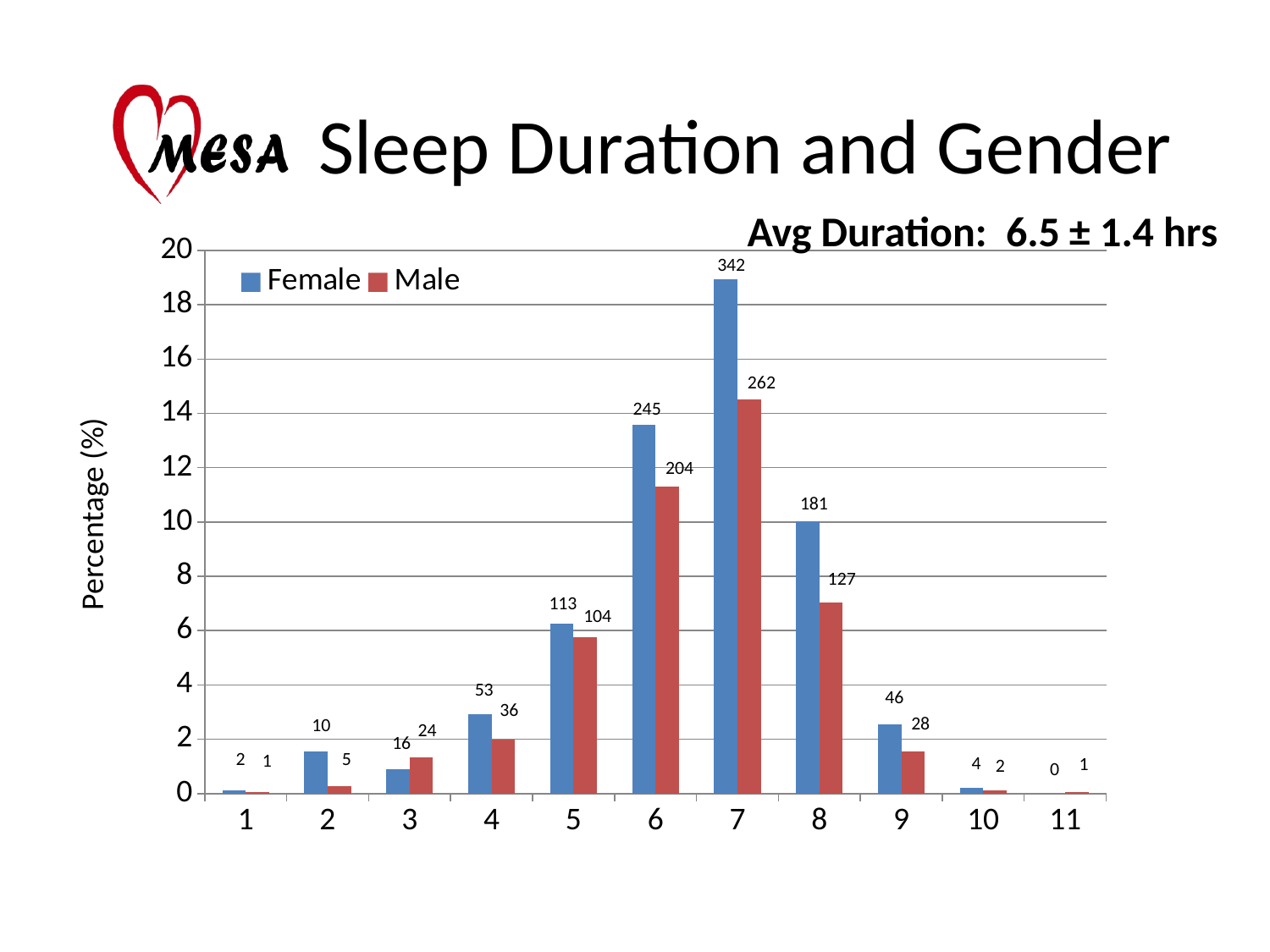
At which sleep duration is the Female bar highest? 7 Is the Female percentage at sleep duration 8 greater or less than 8? greater What data label is printed above the Male bar at sleep duration 8? 127 What data label is printed above the Male bar at sleep duration 6? 204 At which sleep duration is the Male bar highest? 7 What data label is printed above the Female bar at sleep duration 7? 342 Which is larger at sleep duration 3, the Female bar or the Male bar? Male What kind of chart is shown on the slide? bar chart What is the difference between the Female and Male data labels at sleep duration 7? 80 What average sleep duration is stated on the slide? 6.5 ± 1.4 hrs How many series does the legend list? 2 How many sleep-duration categories are shown on the x axis? 11